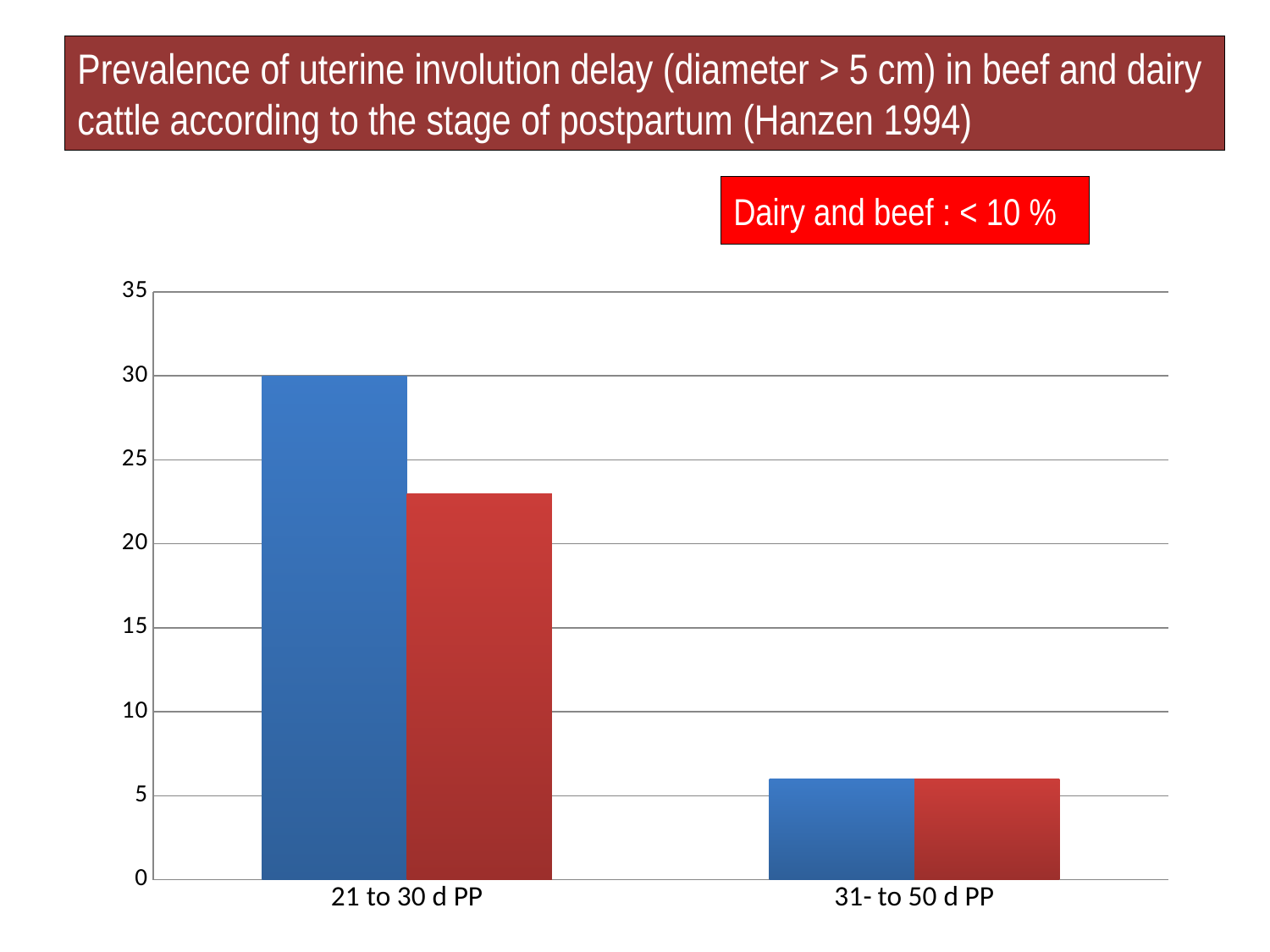
What kind of chart is shown on the slide? bar chart For the category 21 to 30 d PP, which bar is taller, the blue one or the red one? the blue one Is the value of the red bar for 21 to 30 d PP greater or less than 20? greater Is the value of the blue bar for 31- to 50 d PP greater or less than 10? less How many categories are shown on the x axis of the chart? 2 What is the highest value shown on the vertical axis of the chart? 35 Which category has the highest value for the blue bars? 21 to 30 d PP Is the value of the red bar for 31- to 50 d PP greater or less than 5? greater Do the values rise or fall from 21 to 30 d PP to 31- to 50 d PP? fall What is the value of the blue bar for the category 21 to 30 d PP? 30 Which category has the lowest value for the red bars? 31- to 50 d PP